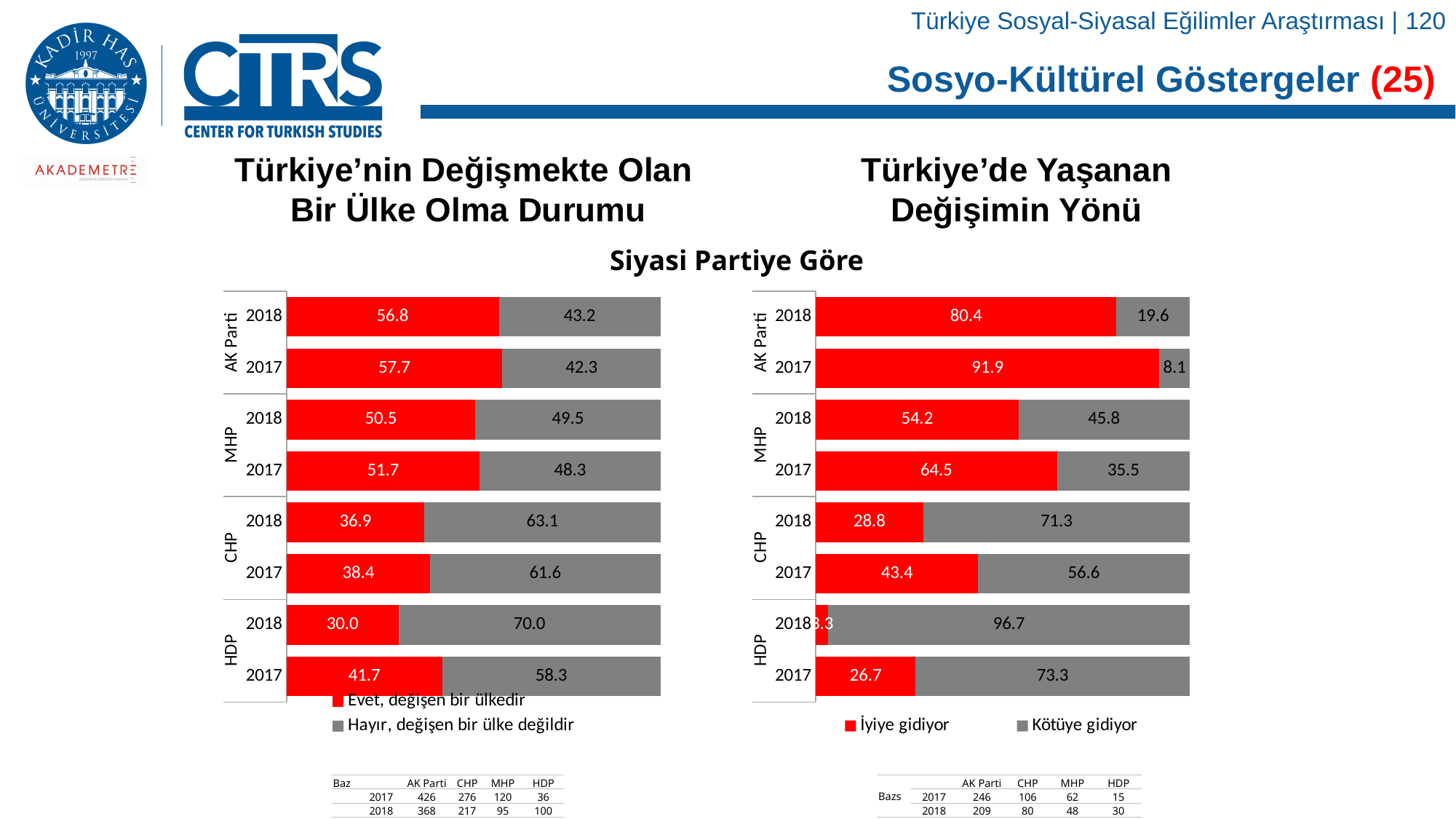
In the left chart (Türkiye'nin Değişmekte Olan Bir Ülke Olma Durumu), what is the total of the stacked bar for MHP 2018? 100 In the right chart (Türkiye'de Yaşanan Değişimin Yönü), what is the value of 'Kötüye gidiyor' for CHP in 2018? 71.3 In the left chart (Türkiye'nin Değişmekte Olan Bir Ülke Olma Durumu), what is the value of 'Evet, değişen bir ülkedir' for AK Parti in 2018? 56.8 What are the two legend entries of the right chart (Türkiye'de Yaşanan Değişimin Yönü)? İyiye gidiyor; Kötüye gidiyor How many series does the legend of the left chart (Türkiye'nin Değişmekte Olan Bir Ülke Olma Durumu) list? 2 In the left chart (Türkiye'nin Değişmekte Olan Bir Ülke Olma Durumu), which is larger: the 'Hayır, değişen bir ülke değildir' value for CHP 2018 or for HDP 2017? CHP 2018 In the left chart (Türkiye'nin Değişmekte Olan Bir Ülke Olma Durumu), which party-year bar has the highest 'Evet, değişen bir ülkedir' value? AK Parti 2017 In the left chart (Türkiye'nin Değişmekte Olan Bir Ülke Olma Durumu), which party-year bar has the lowest 'Evet, değişen bir ülkedir' value? HDP 2018 In the right chart (Türkiye'de Yaşanan Değişimin Yönü), what is the difference between the 'İyiye gidiyor' values for MHP in 2017 and 2018? 10.3 What type of chart is the right chart (Türkiye'de Yaşanan Değişimin Yönü)? Stacked bar chart In the right chart (Türkiye'de Yaşanan Değişimin Yönü), what is the value of 'İyiye gidiyor' for AK Parti in 2017? 91.9 How many bars are plotted in the right chart (Türkiye'de Yaşanan Değişimin Yönü)? 8